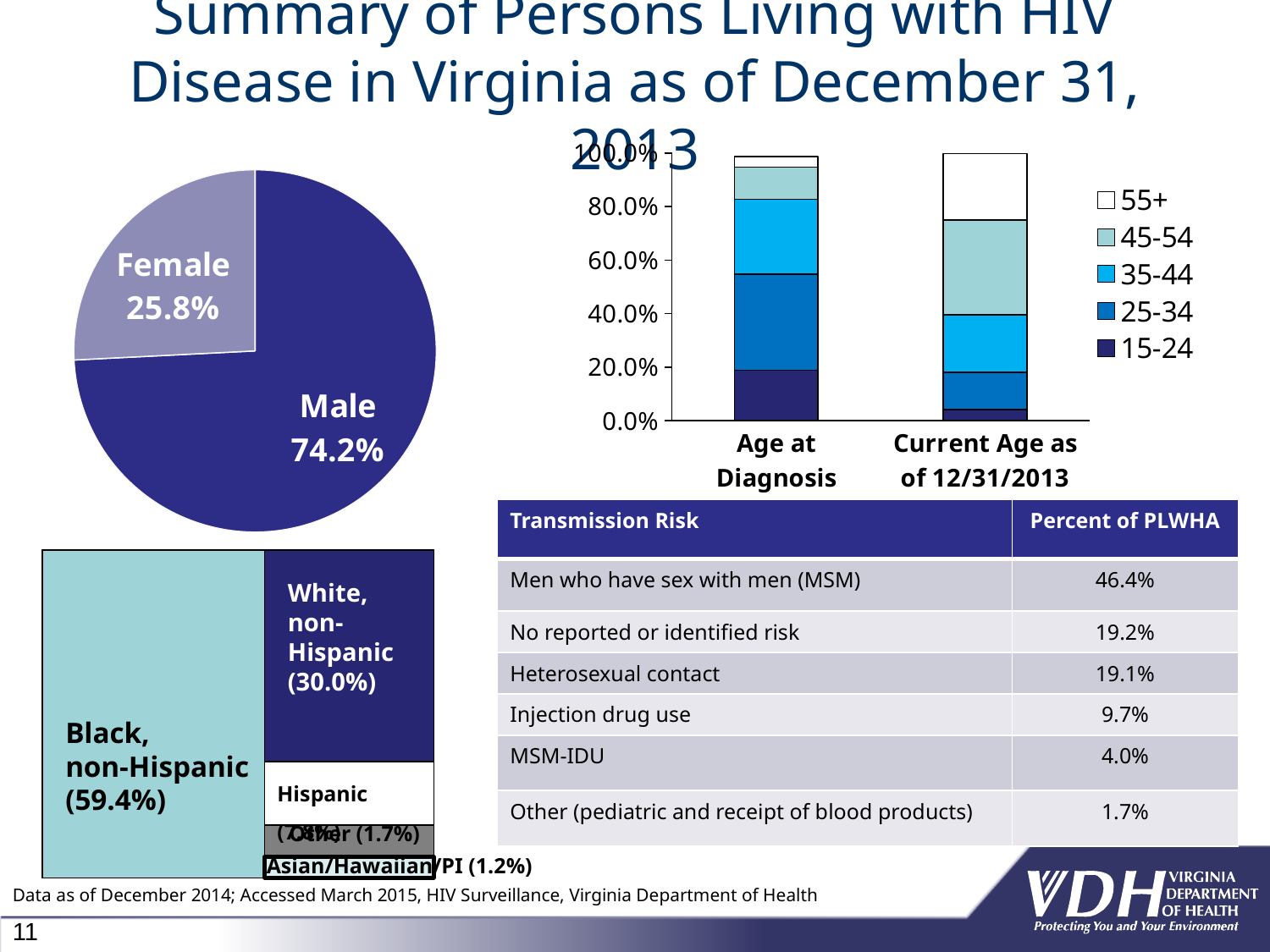
How many age groups does the legend of the stacked bar chart on the right list? 5 In the pie chart on the left, what percentage of persons living with HIV disease are male? 74.2% In the pie chart on the left, what percentage of persons living with HIV disease are female? 25.8% In the stacked bar chart on the right, is the 15-24 segment for Current Age as of 12/31/2013 greater or less than 20.0%? less In the race/ethnicity chart at the bottom left, what percentage is shown for White, non-Hispanic? 30.0% In the race/ethnicity chart at the bottom left, what is the difference in percentage points between Black, non-Hispanic and White, non-Hispanic? 29.4% In the race/ethnicity chart at the bottom left, what percentage is shown for Asian/Hawaiian/PI? 1.2% What type of chart is the sex breakdown chart on the left of the slide? Pie chart In the pie chart on the left, what is the difference in percentage points between the Male and Female slices? 48.4% In the stacked bar chart on the right, is the 15-24 segment larger for Age at Diagnosis or for Current Age as of 12/31/2013? Age at Diagnosis In the pie chart on the left, which slice is larger, Male or Female? Male In the race/ethnicity chart at the bottom left, what percentage is shown for Black, non-Hispanic? 59.4%